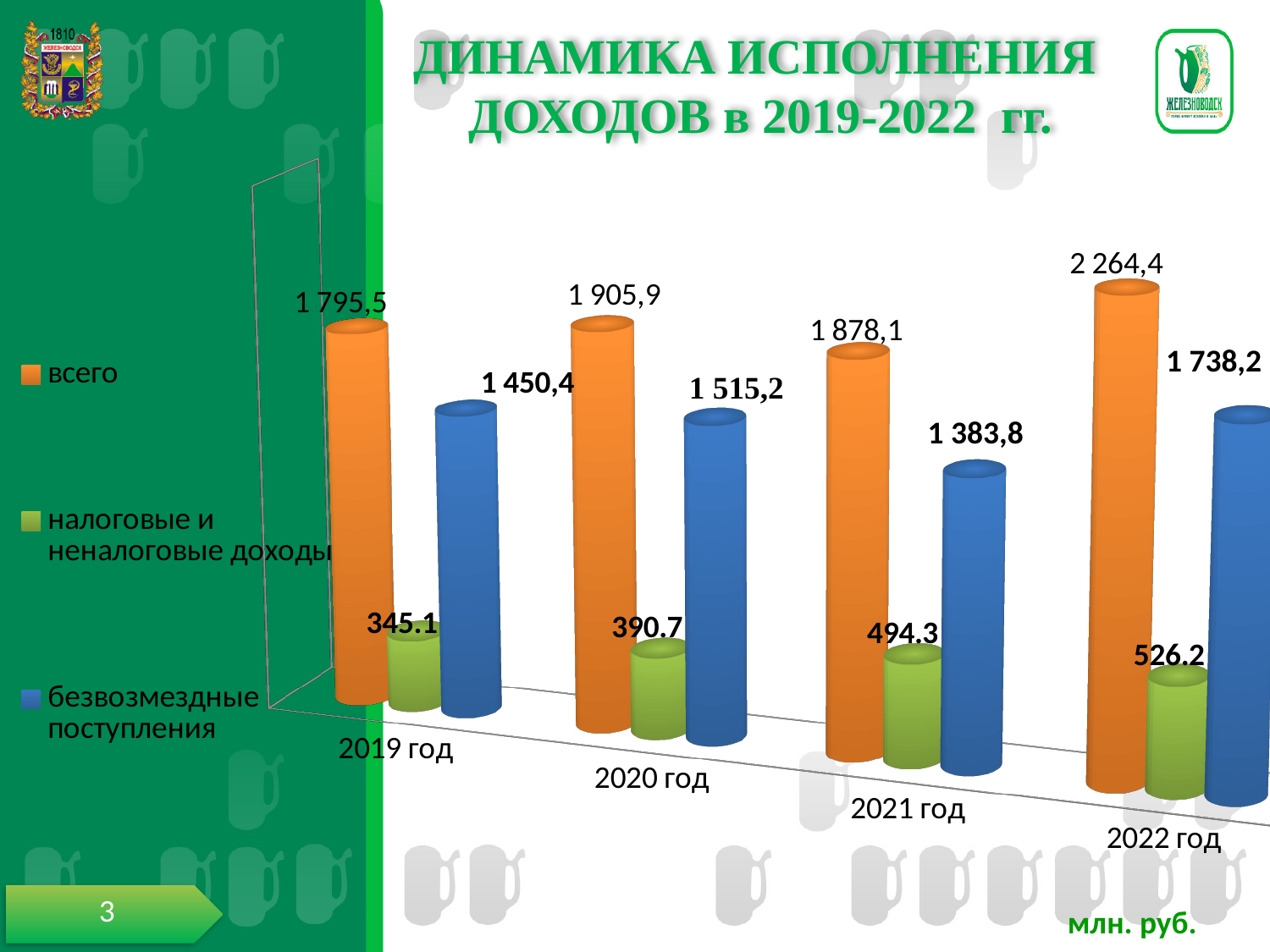
What is the value of «безвозмездные поступления» for 2021 год? 1 383,8 In which year is «налоговые и неналоговые доходы» the lowest? 2019 год Which is larger: «всего» in 2020 год or «всего» in 2021 год? 2020 год What is the value of «всего» for 2019 год? 1 795,5 How many years (categories) are shown on the chart? 4 What is the difference between «всего» in 2022 год and in 2021 год? 386,3 What kind of chart is shown on the slide? bar chart In which year is «всего» the highest? 2022 год What is the value of «налоговые и неналоговые доходы» for 2022 год? 526.2 How many series does the legend list? 3 What unit of measurement is indicated for the chart values? млн. руб. Do the values of «налоговые и неналоговые доходы» rise or fall from 2019 год to 2022 год? rise